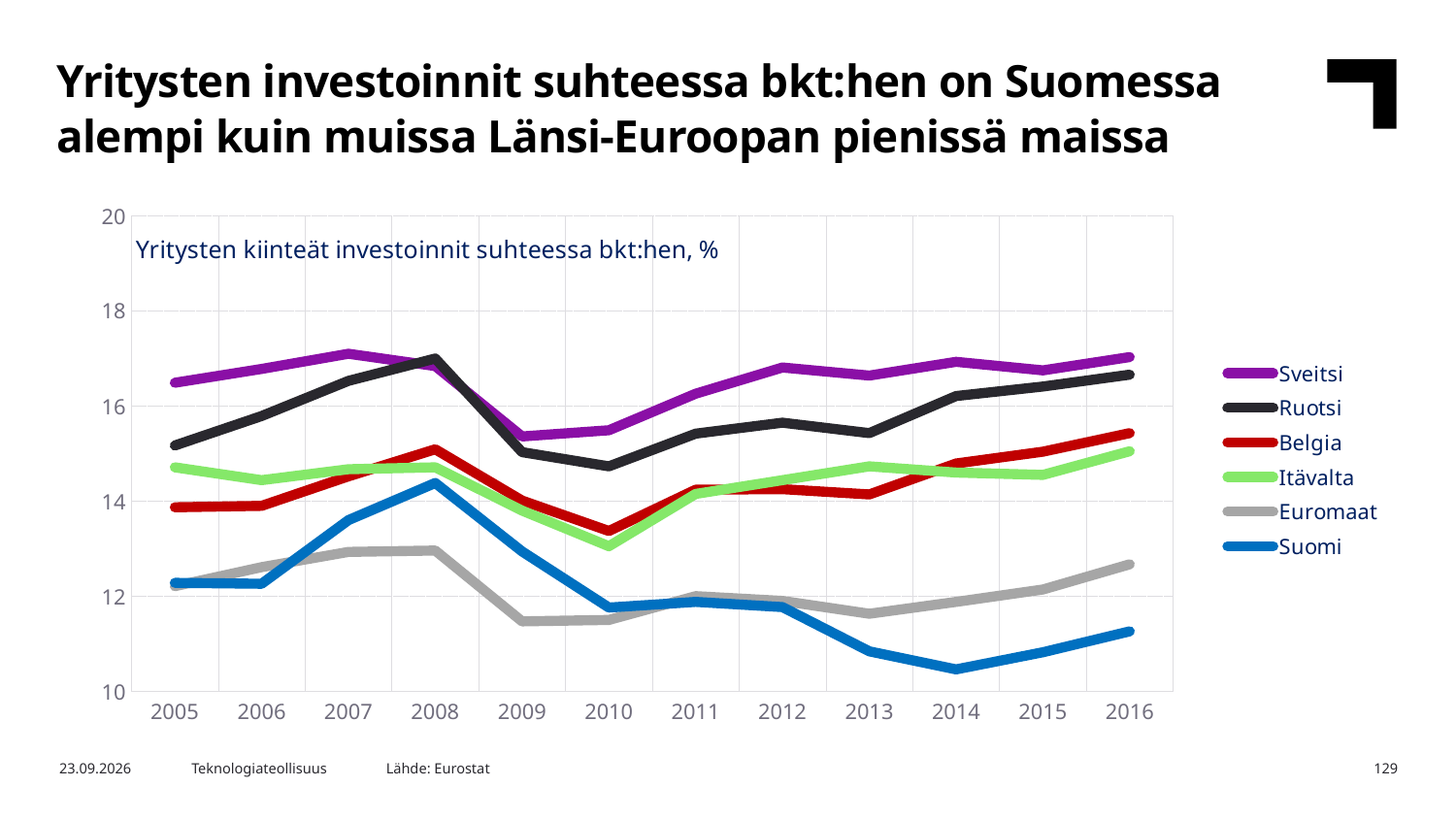
In 2008, which is higher: Suomi or Euromaat? Suomi Is the value for Euromaat in 2009 greater or less than 12? less Is the value for Suomi in 2014 greater or less than 12? less What is the title printed inside the chart area? Yritysten kiinteät investoinnit suhteessa bkt:hen, % How many years are shown on the x axis? 12 Which country has the highest value in 2012? Sveitsi What kind of chart is shown on the slide? Line chart In 2016, which is higher: Ruotsi or Belgia? Ruotsi How many series does the legend list? 6 Which series has the lowest value in 2014? Suomi Does the Suomi line rise or fall from 2008 to 2014? Fall Is the value for Sveitsi in 2007 greater or less than 16? greater